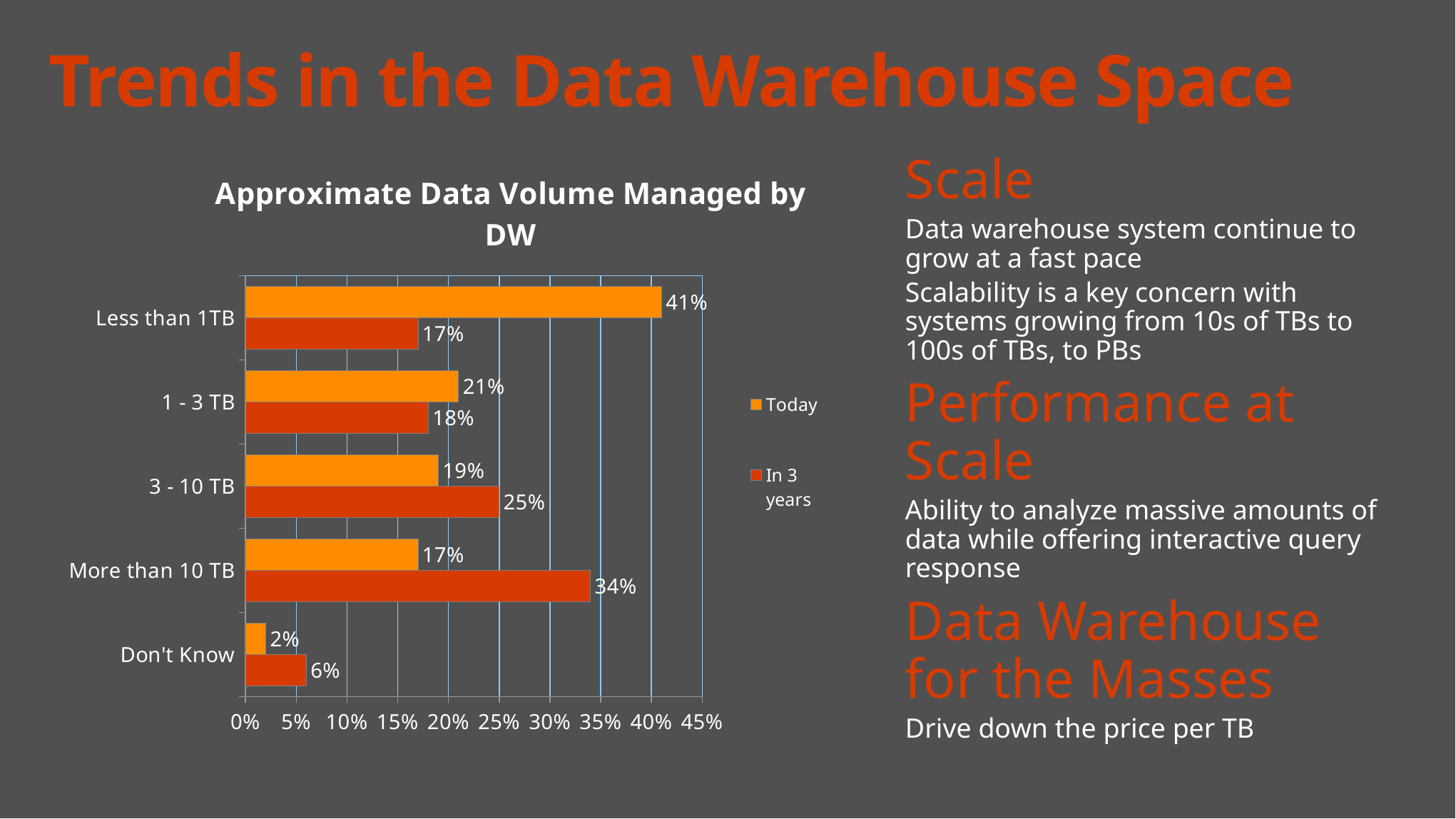
How many series does the legend list? 2 What is the value for "Less than 1TB" in the Today series? 41% What is the value for "3 - 10 TB" in the In 3 years series? 25% What is the value for "Don't Know" in the Today series? 2% Which category has the lowest value in the In 3 years series? Don't Know How many categories are shown on the chart? 5 What is the difference between the Today and In 3 years values for "Less than 1TB"? 24% What is the value for "More than 10 TB" in the In 3 years series? 34% What is the title of the chart? Approximate Data Volume Managed by DW What kind of chart is shown on the slide? Bar chart Which category has the highest value in the Today series? Less than 1TB For "More than 10 TB", which series has the larger value, Today or In 3 years? In 3 years